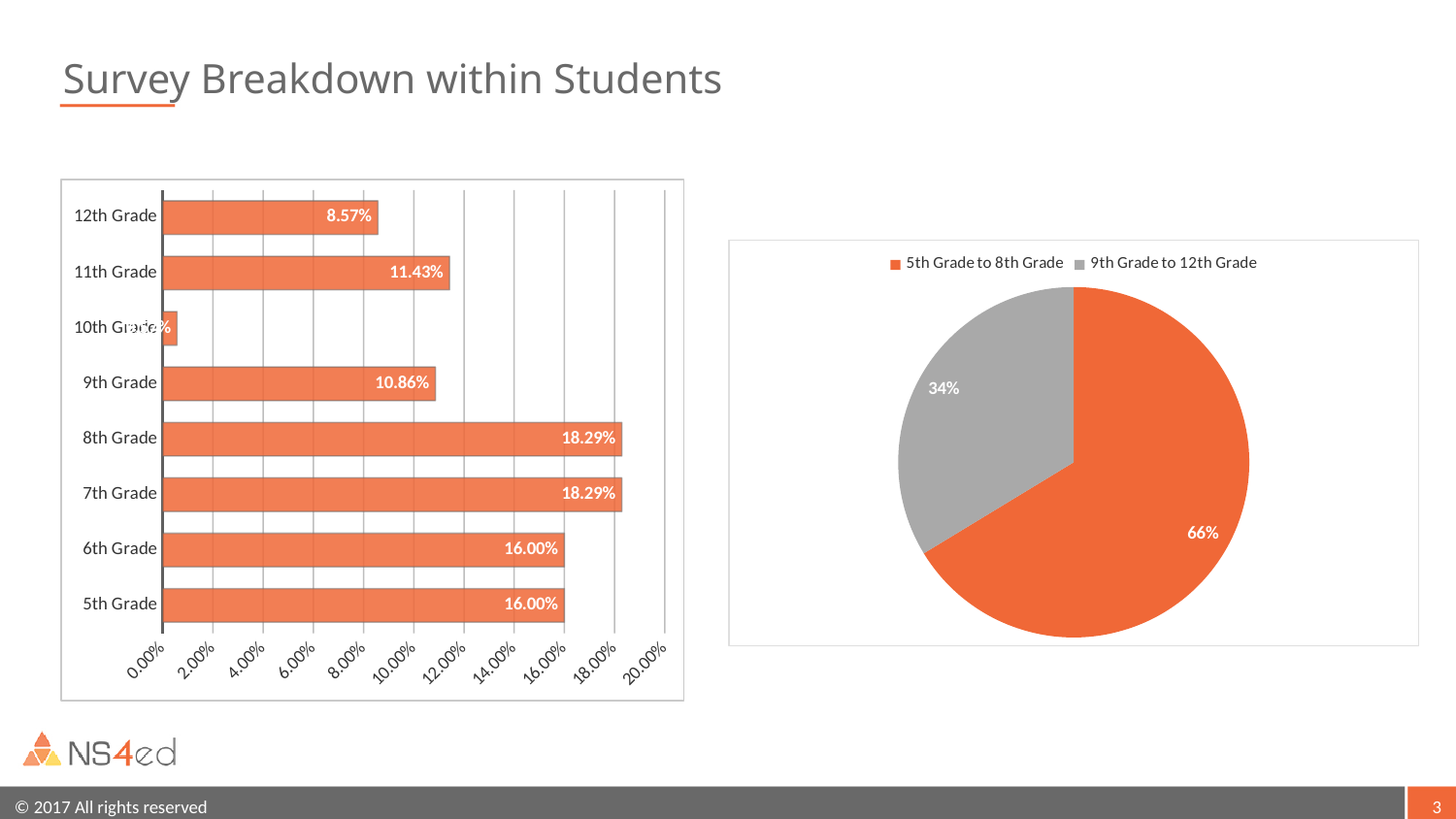
In the bar chart on the left, what is the value for 11th Grade? 11.43% How many grade categories are shown in the bar chart on the left? 8 In the bar chart on the left, which two grades share the highest value? 7th Grade and 8th Grade What kind of chart is the chart on the left of the slide? bar chart In the bar chart on the left, what is the value for 9th Grade? 10.86% In the bar chart on the left, what is the difference between the values for 8th Grade and 12th Grade? 9.72% In the bar chart on the left, is the value for 10th Grade greater or less than 2.00%? less In the bar chart on the left, what is the value for 12th Grade? 8.57% In the bar chart on the left, which grade has the lowest value? 10th Grade In the bar chart on the left, which is larger, the value for 6th Grade or the value for 9th Grade? 6th Grade In the pie chart on the right, what share is shown for 9th Grade to 12th Grade? 34% How many entries does the legend of the pie chart on the right list? 2